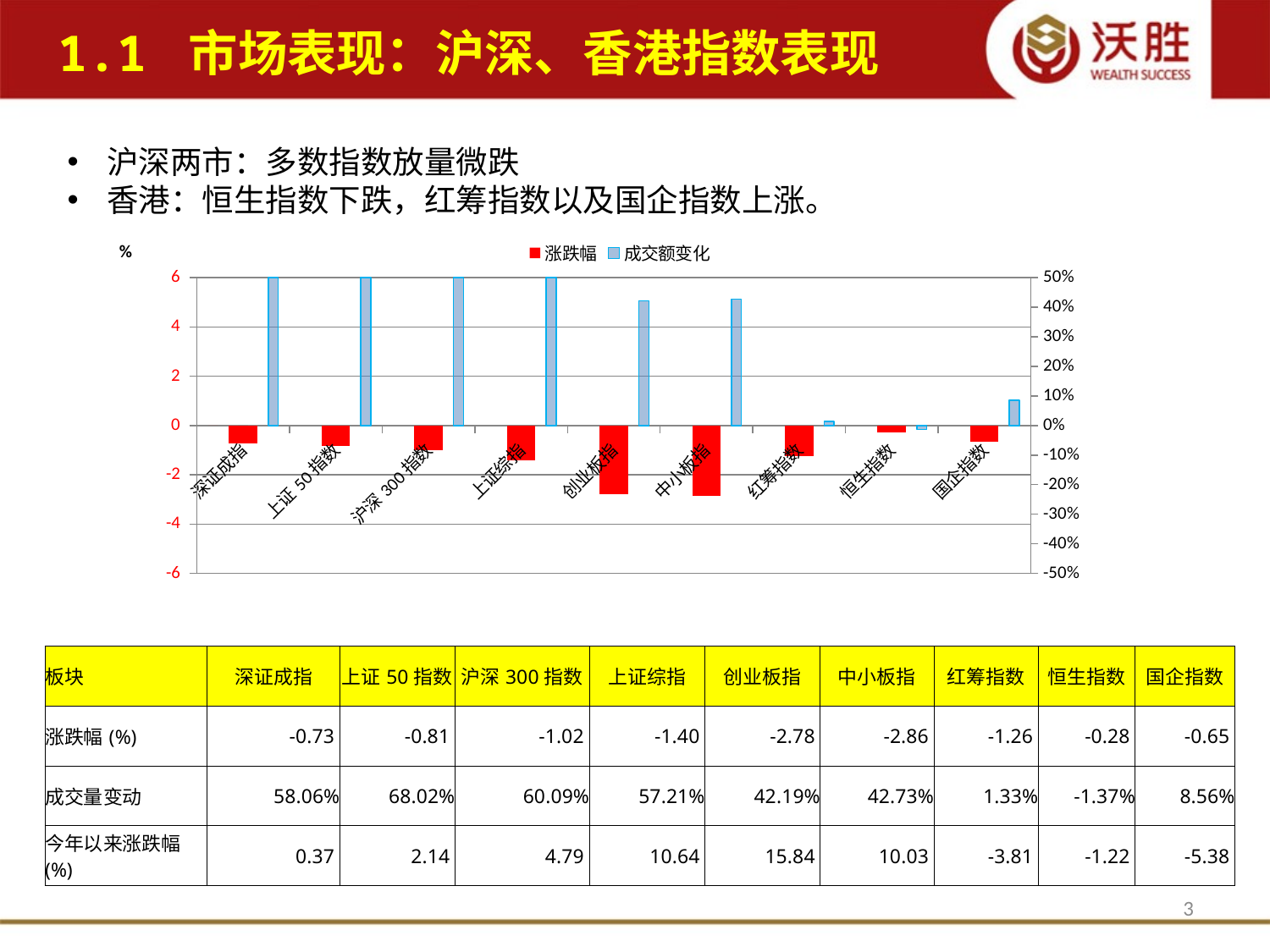
What kind of chart is shown on the slide? bar chart What are the two series named in the chart legend? 涨跌幅 and 成交额变化 Which index has the highest (least negative) 涨跌幅 value? 恒生指数 How many index categories are plotted along the x axis of the chart? 9 What is the difference between the 涨跌幅 (%) values of 深证成指 (-0.73) and 上证 50 指数 (-0.81)? 0.08 What is the 成交量变动 value for 国企指数? 8.56% Which has the larger 成交量变动 value, 红筹指数 or 国企指数? 国企指数 Which index has the highest 成交量变动 value? 上证 50 指数 Which index has the lowest 成交量变动 value? 恒生指数 What is the 涨跌幅 (%) value for 创业板指? -2.78 How many series does the chart legend list? 2 Is the 成交额变化 value for 创业板指 greater or less than 40%? greater